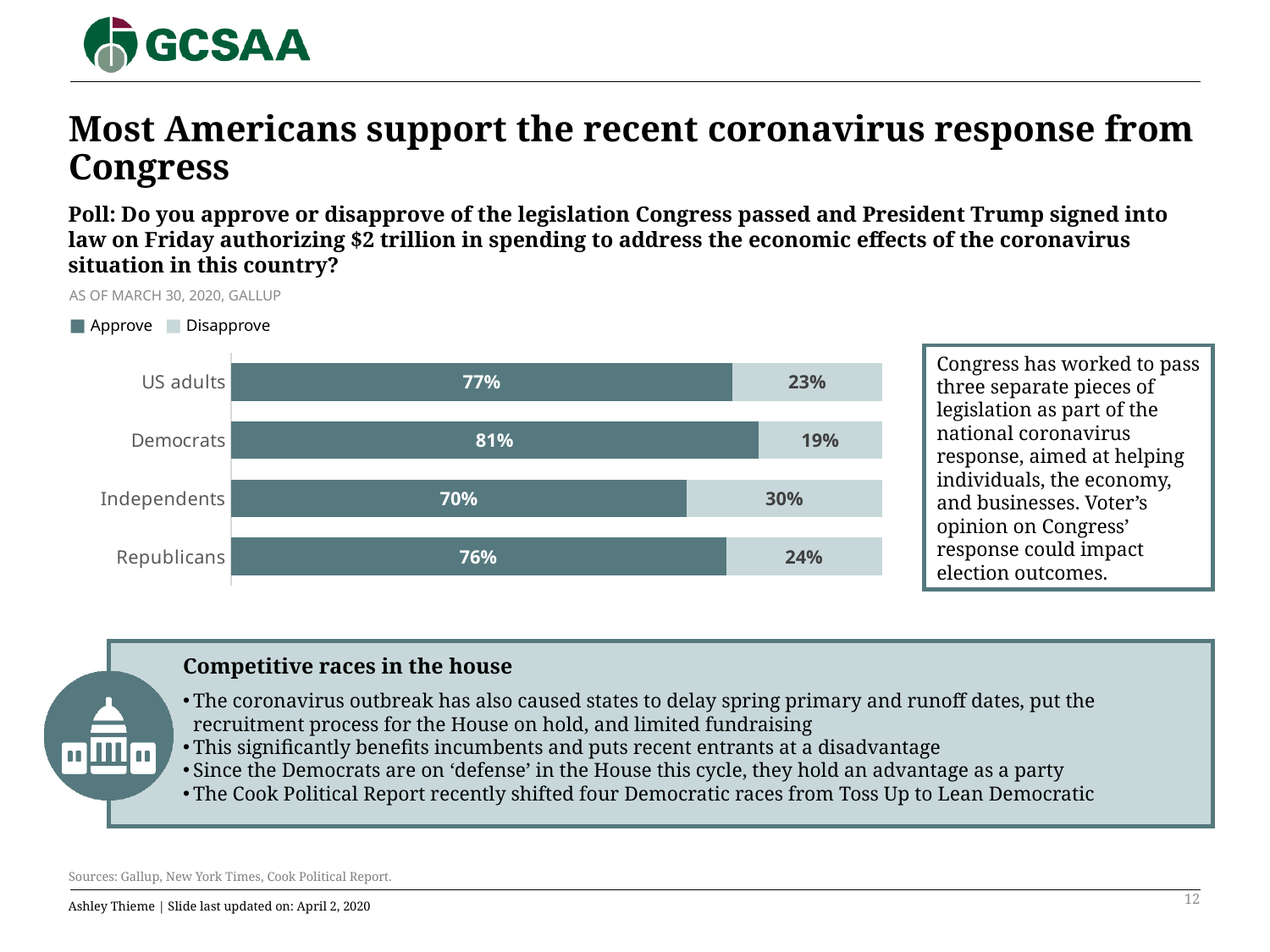
What percentage of Democrats approve of the legislation? 81% Which is larger, the Disapprove value for Republicans or for Democrats? Republicans How many series does the legend list? 2 How many groups are shown on the chart? 4 Which group has the lowest Approve percentage? Independents What is the Disapprove value for US adults? 23% What is the difference between the Approve percentages for Democrats and Independents? 11% What is the Approve value for Republicans? 76% What percentage of Independents disapprove of the legislation? 30% What is the total of the Approve and Disapprove values for Independents? 100% Which group has the highest Approve percentage? Democrats What kind of chart is shown on the slide? Stacked bar chart